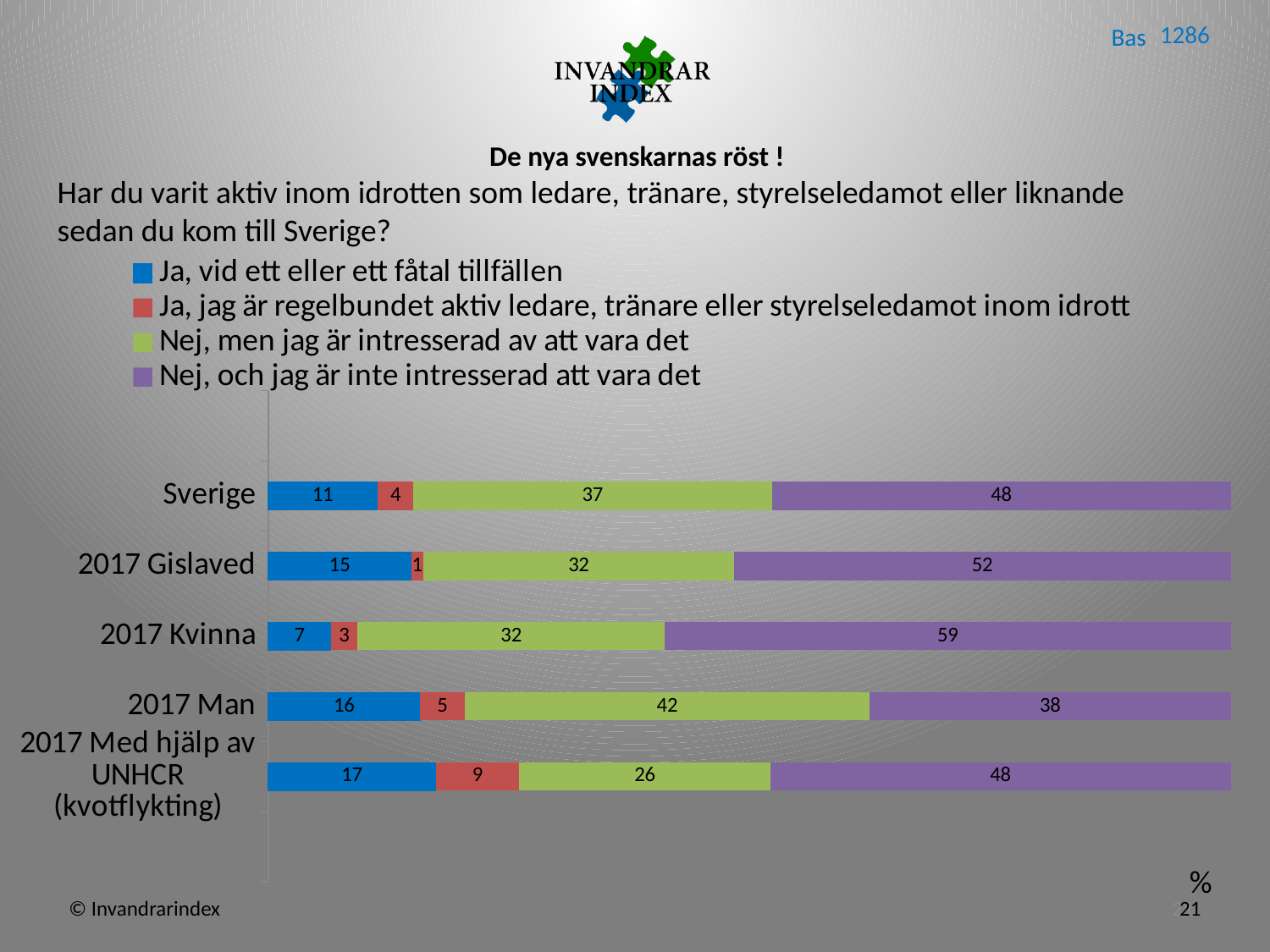
What is the value for 'Nej, men jag är intresserad av att vara det' for 2017 Man? 42 Which category has the lowest value for 'Ja, jag är regelbundet aktiv ledare, tränare eller styrelseledamot inom idrott'? 2017 Gislaved What is the value for 'Ja, vid ett eller ett fåtal tillfällen' for 2017 Med hjälp av UNHCR (kvotflykting)? 17 Which category has the highest value for 'Nej, och jag är inte intresserad att vara det'? 2017 Kvinna What is the difference between the 'Nej, men jag är intresserad av att vara det' values for Sverige and 2017 Med hjälp av UNHCR (kvotflykting)? 11 How many series does the legend list? 4 Which is larger: the 'Ja, vid ett eller ett fåtal tillfällen' value for 2017 Man or for 2017 Kvinna? 2017 Man What kind of chart is shown on the slide? Stacked bar chart What colour represents 'Nej, men jag är intresserad av att vara det' in the chart? Green How many categories are plotted on the chart? 5 What is the total of the stacked bar for 2017 Gislaved? 100 What is the value for 'Nej, och jag är inte intresserad att vara det' for 2017 Kvinna? 59